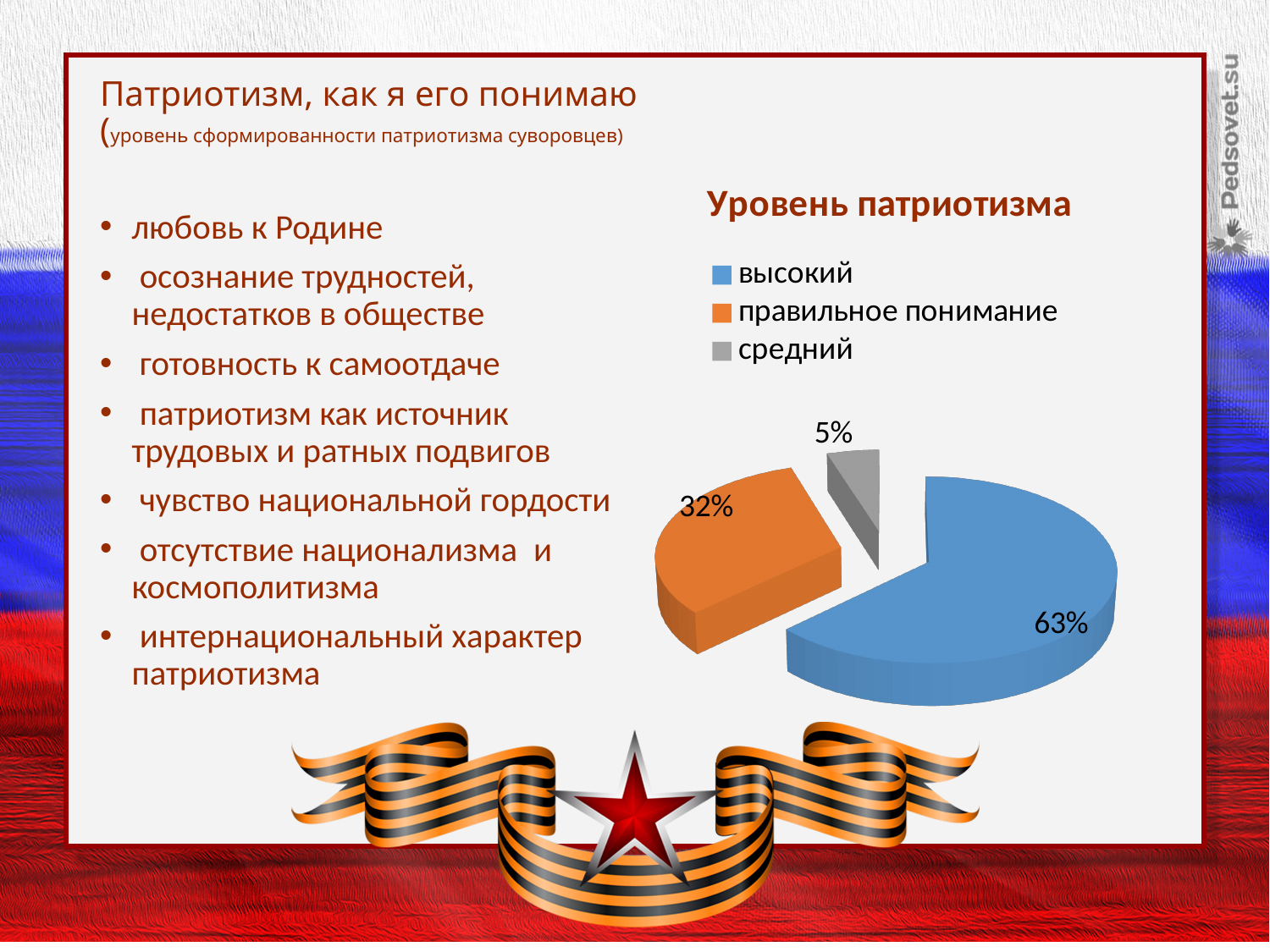
What share of the pie does the 'средний' slice have? 5% What share of the pie does the 'высокий' slice have? 63% How many entries does the legend list? 3 Which is larger, the 'правильное понимание' slice or the 'средний' slice? правильное понимание What share of the pie does the 'правильное понимание' slice have? 32% Which category has the smallest slice of the pie? средний How many slices does the pie chart have? 3 What is the title of the chart? Уровень патриотизма What kind of chart is shown on the slide? pie chart What colour is the 'высокий' slice in the pie chart? blue Which category has the largest slice of the pie? высокий What is the difference in percentage points between the 'высокий' and 'правильное понимание' slices? 31